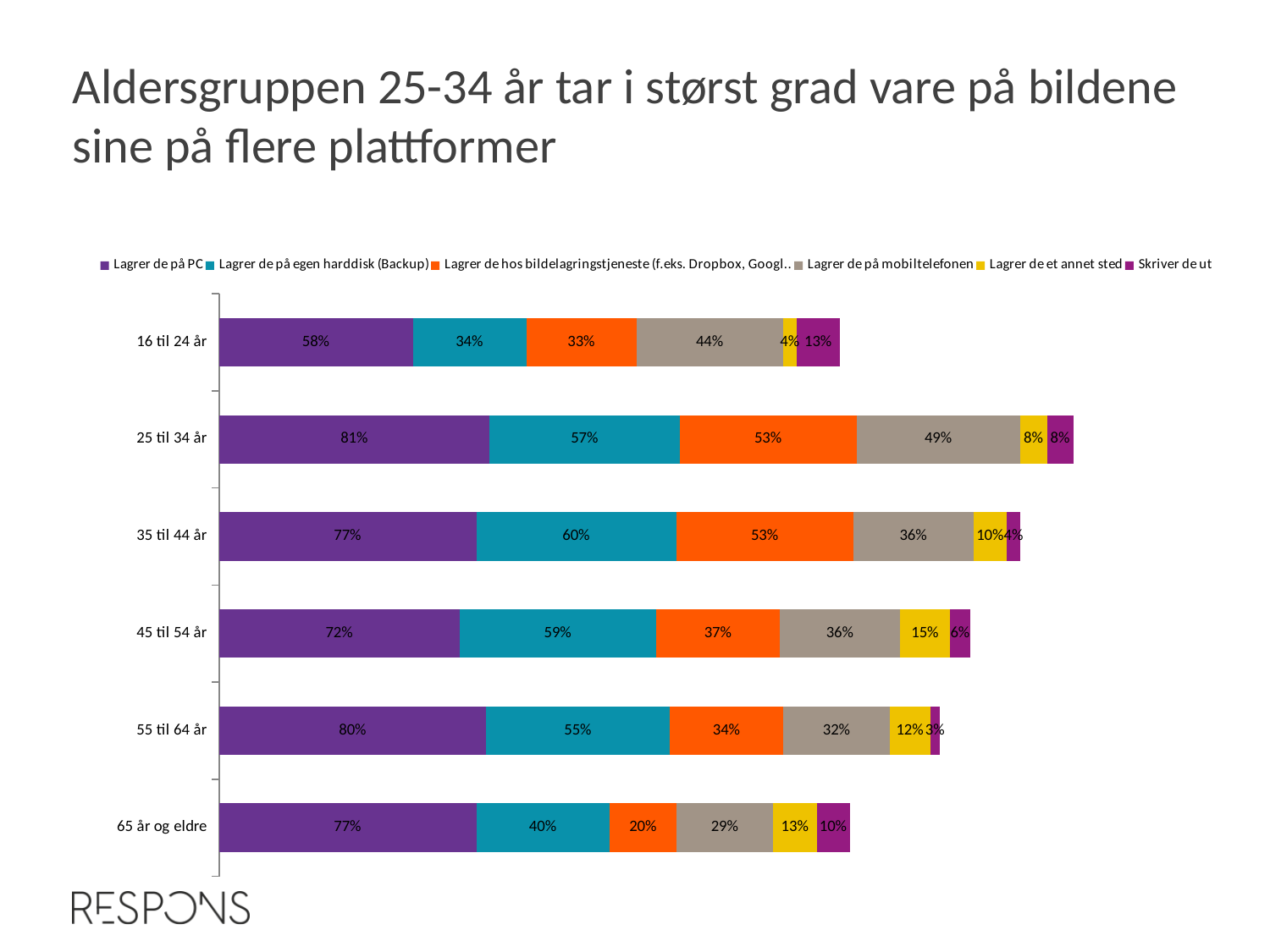
How many series does the legend list? 6 What is the difference between the 'Lagrer de på PC' values for 25 til 34 år and 16 til 24 år? 23 percentage points What is the value for 'Lagrer de hos bildelagringstjeneste' in the 65 år og eldre group? 20% What is the total of the stacked bar for 16 til 24 år? 186% How many age groups are shown on the chart? 6 What is the value for 'Lagrer de på PC' in the 25 til 34 år group? 81% Which series is shown in orange in the legend? Lagrer de hos bildelagringstjeneste (f.eks. Dropbox, Googl..) Which is larger: 'Lagrer de et annet sted' for 45 til 54 år or for 55 til 64 år? 45 til 54 år What is the value for 'Lagrer de på mobiltelefonen' in the 16 til 24 år group? 44% Which age group has the lowest value for 'Lagrer de på egen harddisk (Backup)'? 16 til 24 år What type of chart is shown on the slide? Stacked bar chart Which age group has the highest value for 'Lagrer de på PC'? 25 til 34 år